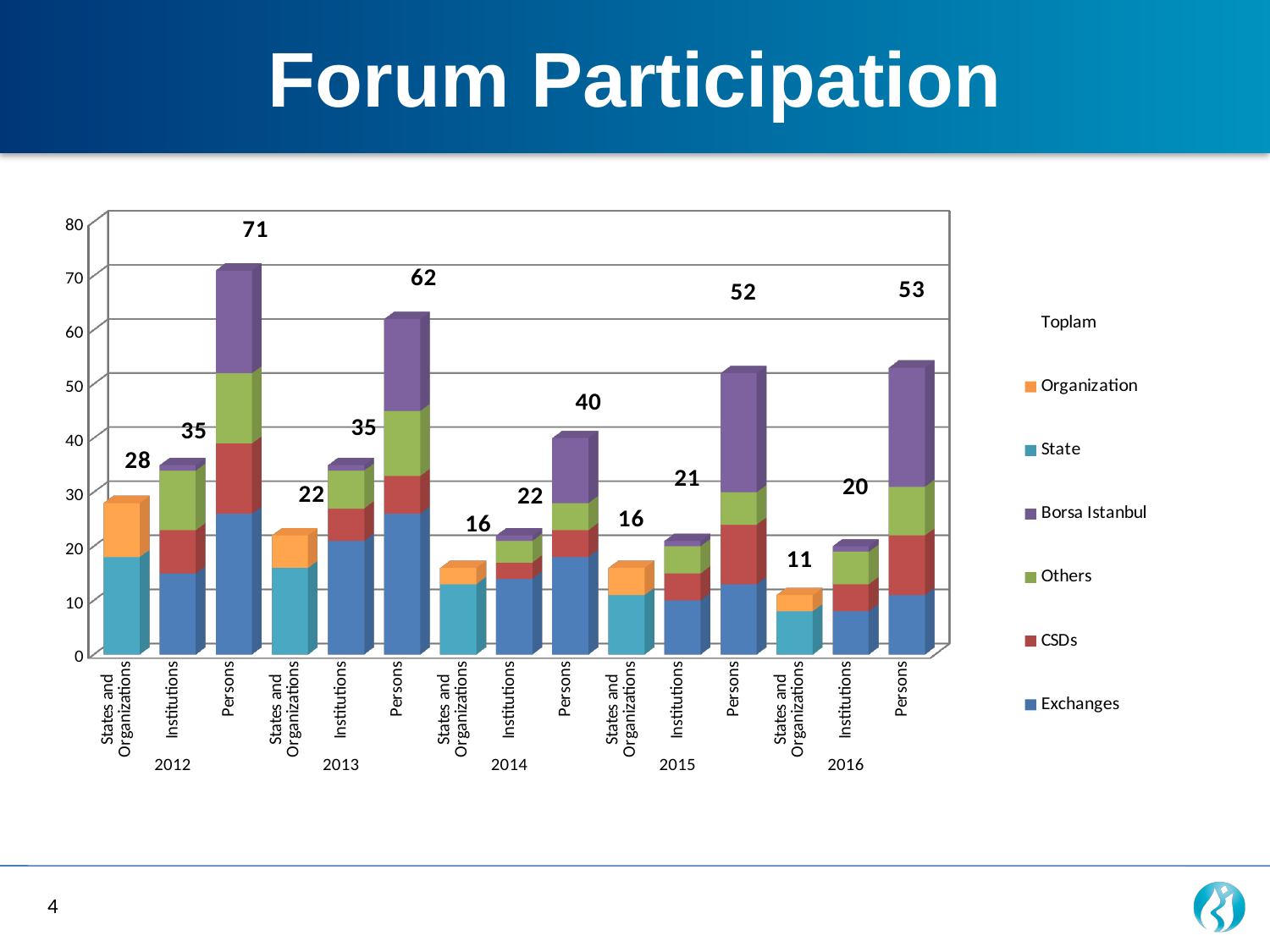
What is the total labelled for Persons in 2012? 71 Which is larger, the Persons total for 2015 or for 2016? 2016 Do the States and Organizations totals rise or fall from 2012 to 2016? fall What is the total labelled for States and Organizations in 2016? 11 What is the difference between the Persons totals for 2012 and 2013? 9 What kind of chart is shown on the slide? Stacked bar chart Which bar has the lowest labelled total? States and Organizations in 2016 What is the total labelled for Institutions in 2014? 22 Which bar has the highest labelled total? Persons in 2012 What colour represents Borsa Istanbul in the legend? Purple Is the Exchanges segment of the 2012 Persons bar greater or less than 20? greater How many bars are plotted in the chart? 15